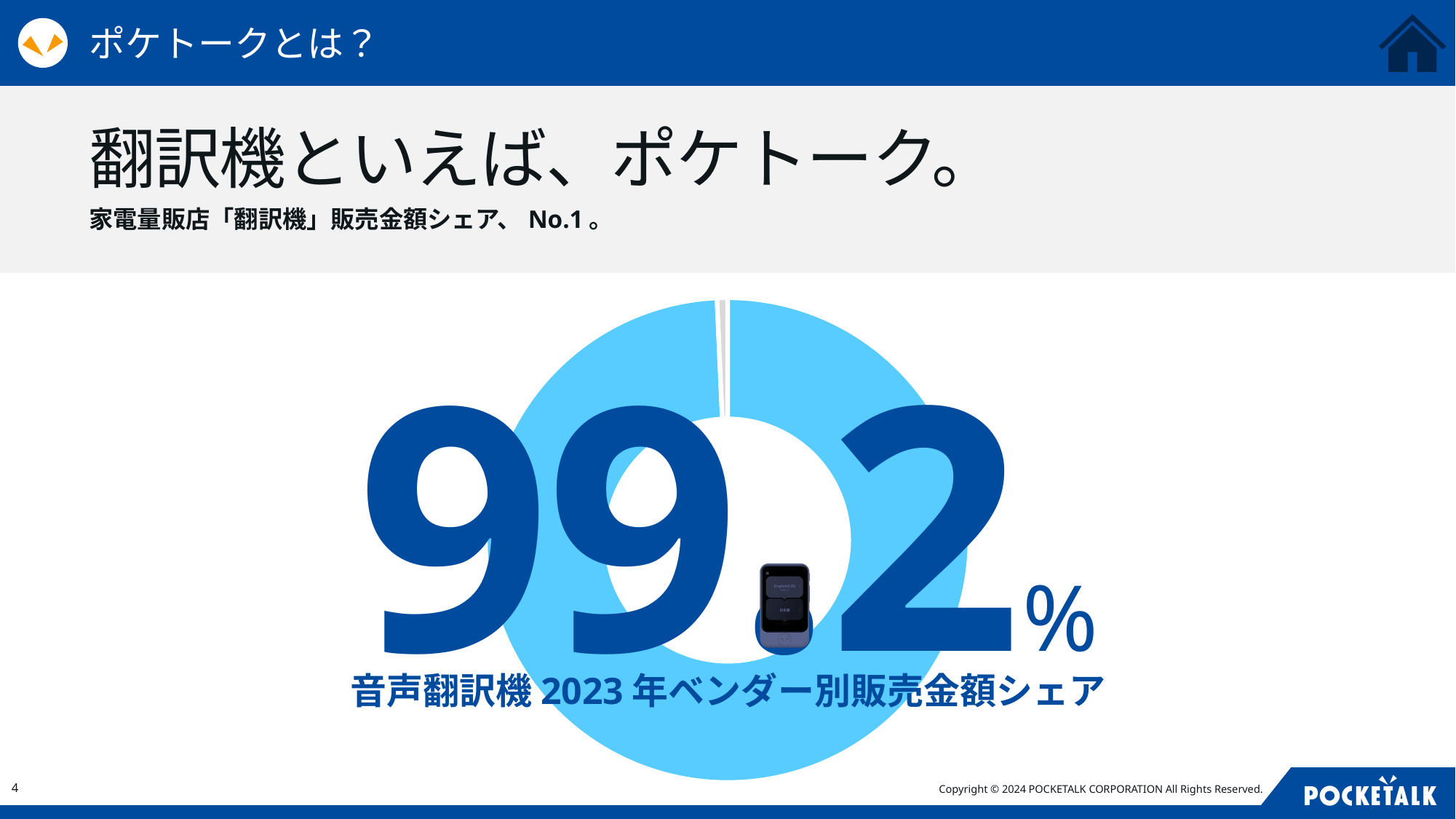
According to the chart, what is Pocketalk's share of 2023 voice translator sales value by vendor? 99.2% Does the large light blue slice represent the highest or the lowest share in the chart? Highest What kind of chart is shown on the slide? Pie (donut) chart What is the caption printed below the large percentage on the chart? 音声翻訳機 2023 年ベンダー別販売金額シェア Which slice of the chart is larger, the light blue slice or the thin white/grey sliver? The light blue slice What percentage share is printed in large figures over the chart? 99.2% Is the share shown for Pocketalk greater or less than 90%? greater Which year does the chart's sales-value share refer to? 2023 How many slices does the donut chart contain? 2